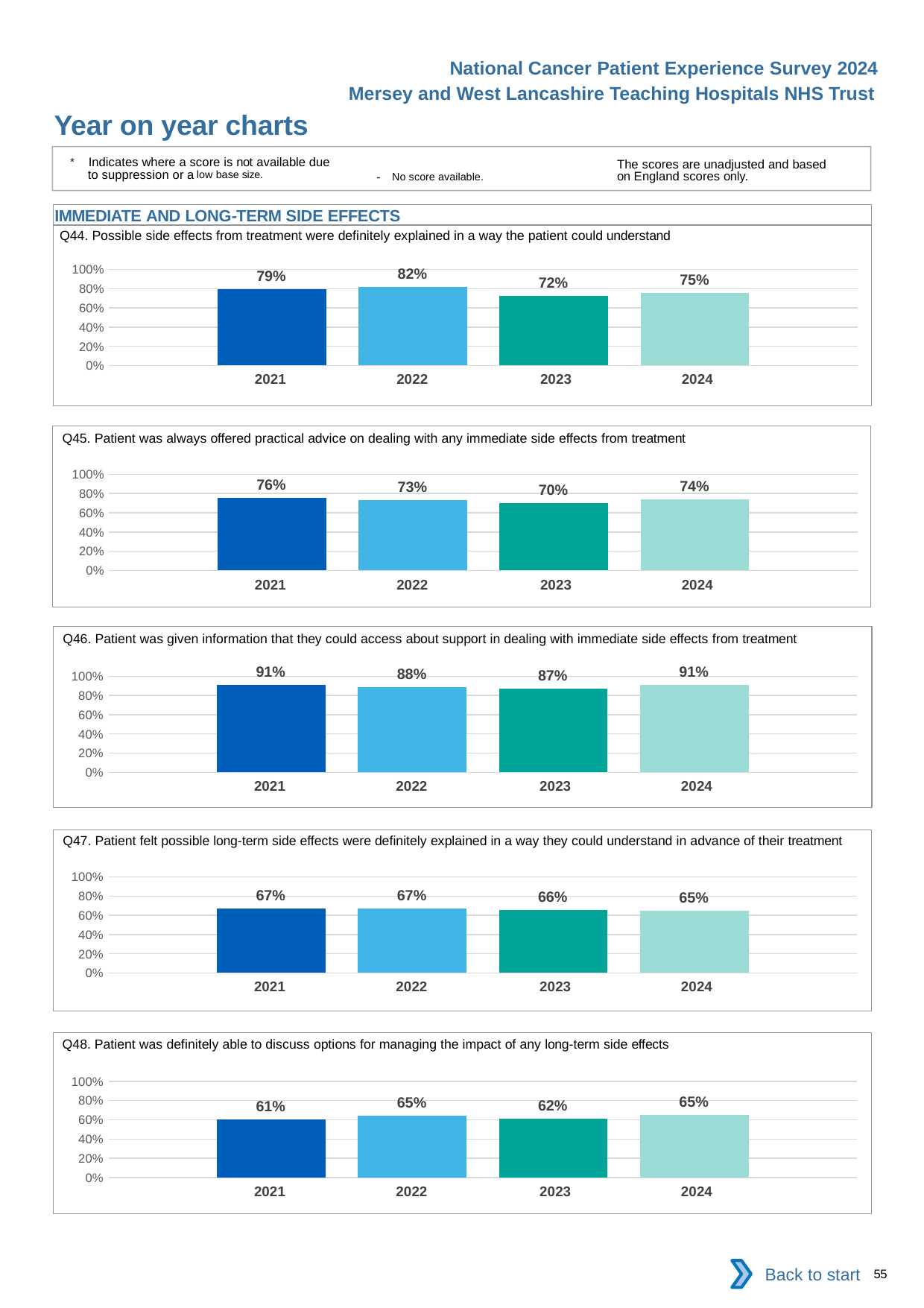
In the Q45 chart, what is the difference between the 2021 and 2023 values? 6% What type of chart is the Q44 chart? bar chart In the Q46 chart, is the value for 2022 greater or less than 80%? greater In the Q48 chart, what is the difference between the 2022 and 2023 values? 3% In the Q45 chart, which year has the highest value? 2021 In the Q44 chart, which year has the lowest value? 2023 In the Q44 chart, what is the value for 2022? 82% In the Q47 chart, do the values rise or fall from 2021 to 2024? fall How many years are shown in the Q48 chart? 4 In the Q46 chart, what is the value for 2023? 87% In the Q47 chart, which is larger, the value for 2023 or the value for 2024? 2023 In the Q48 chart, what is the value for 2021? 61%